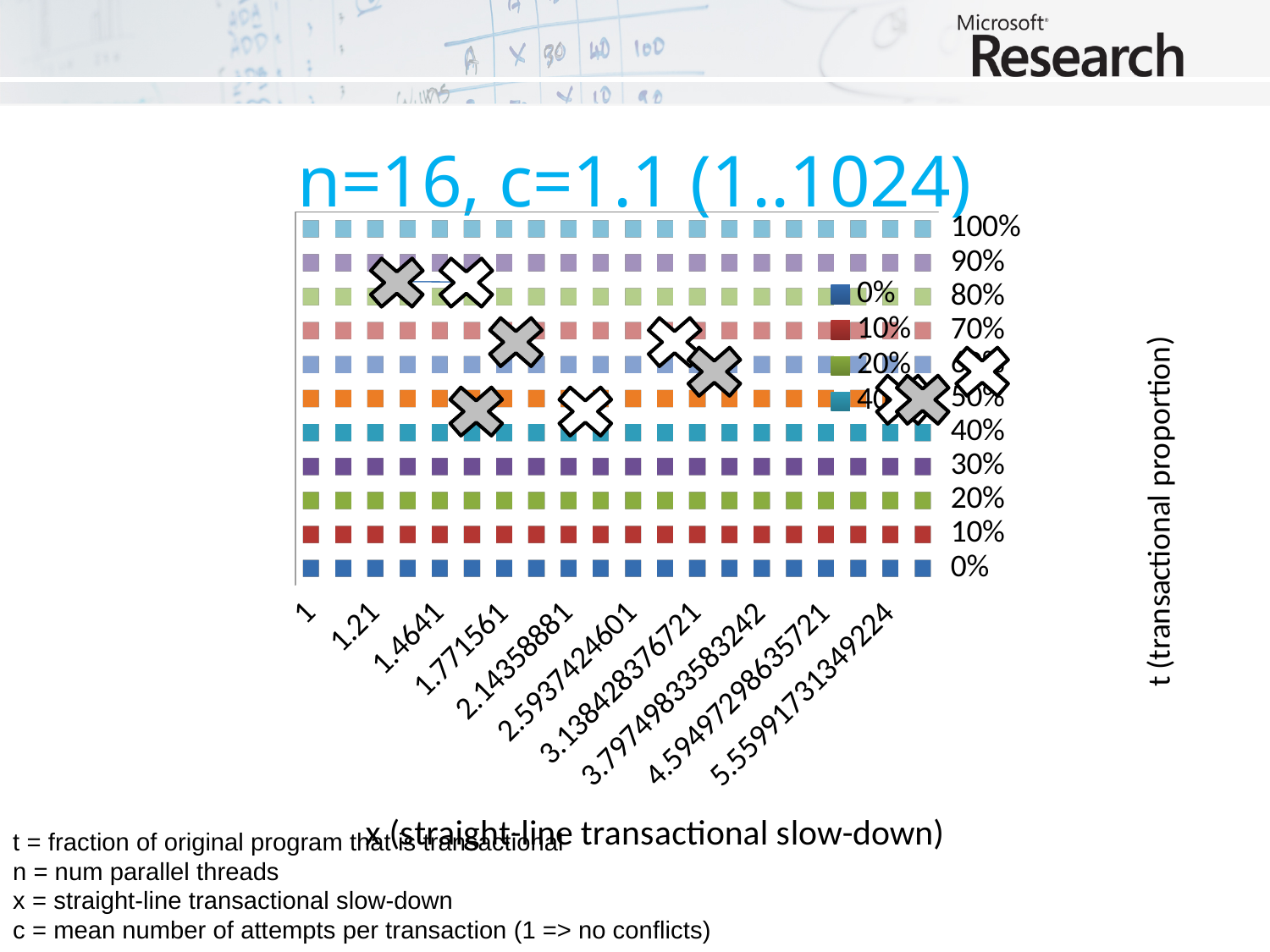
What is the second label on the x axis of the chart? 1.21 At which y-axis value does the row of orange markers sit? 50% What is the title of the chart? n=16, c=1.1 (1..1024) What is the lowest value labelled on the y axis of the chart? 0% What kind of chart is shown on the slide? scatter chart How many tick labels are shown on the y axis of the chart? 11 What is the title of the x axis of the chart? x (straight-line transactional slow-down) Do the x-axis label values increase or decrease from left to right? increase What is the highest value labelled on the y axis of the chart? 100% How many category labels are shown along the x axis of the chart? 10 What is the first label on the x axis of the chart? 1 What is the third label on the x axis of the chart? 1.4641